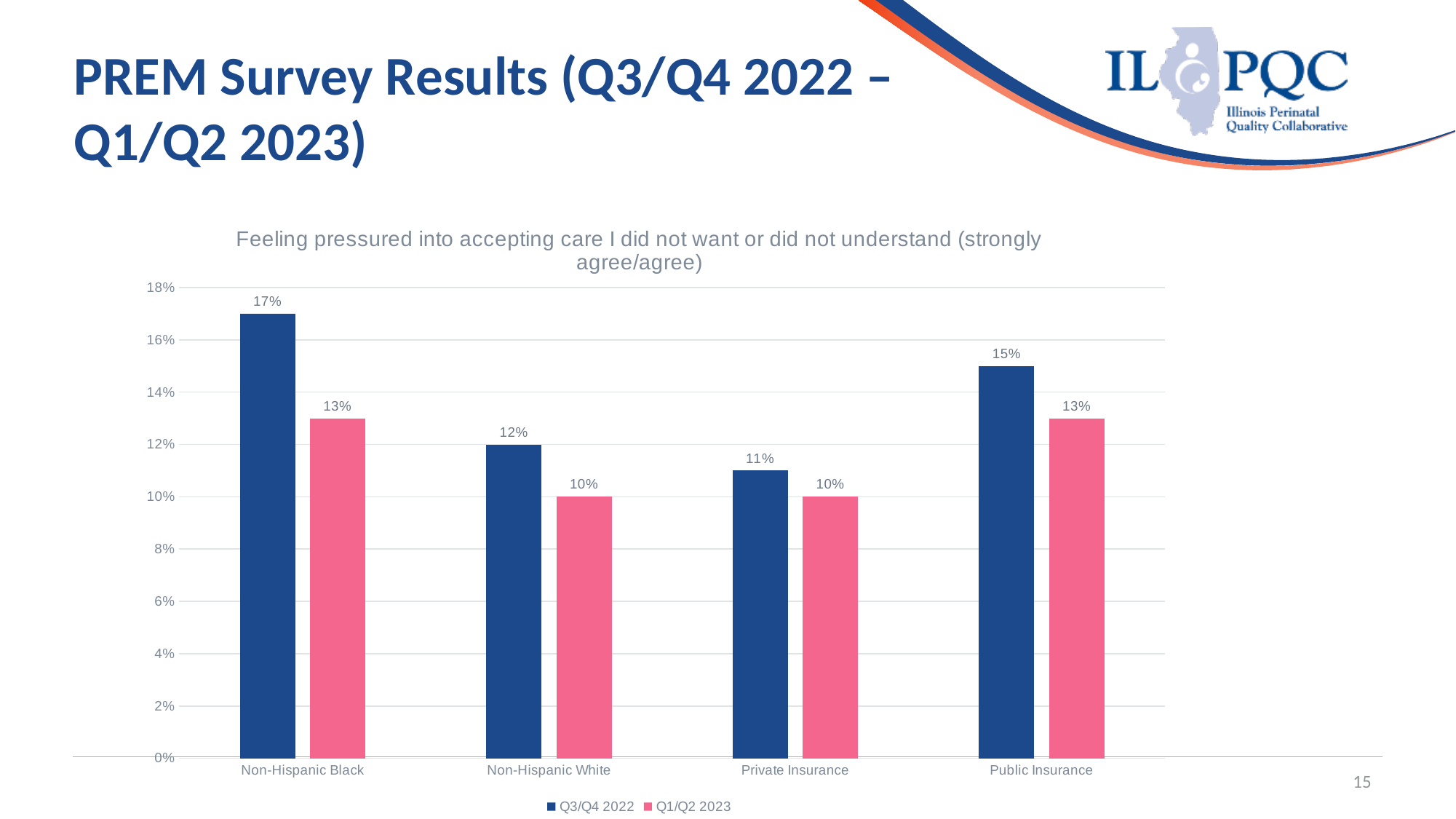
What kind of chart is shown on the slide? Bar chart What is the difference between the Q3/Q4 2022 and Q1/Q2 2023 values for Non-Hispanic Black? 4% Is the Q3/Q4 2022 value for Public Insurance greater or less than 14%? greater What is the Q1/Q2 2023 value for Non-Hispanic White? 10% What is the Q3/Q4 2022 value for Non-Hispanic Black? 17% Which category has the highest Q3/Q4 2022 value? Non-Hispanic Black How many categories are shown on the x axis? 4 What is the Q1/Q2 2023 value for Public Insurance? 13% How many series does the legend list? 2 What is the title of the chart? Feeling pressured into accepting care I did not want or did not understand (strongly agree/agree) Which is larger for Public Insurance: the Q3/Q4 2022 value or the Q1/Q2 2023 value? Q3/Q4 2022 Which category has the lowest Q3/Q4 2022 value? Private Insurance